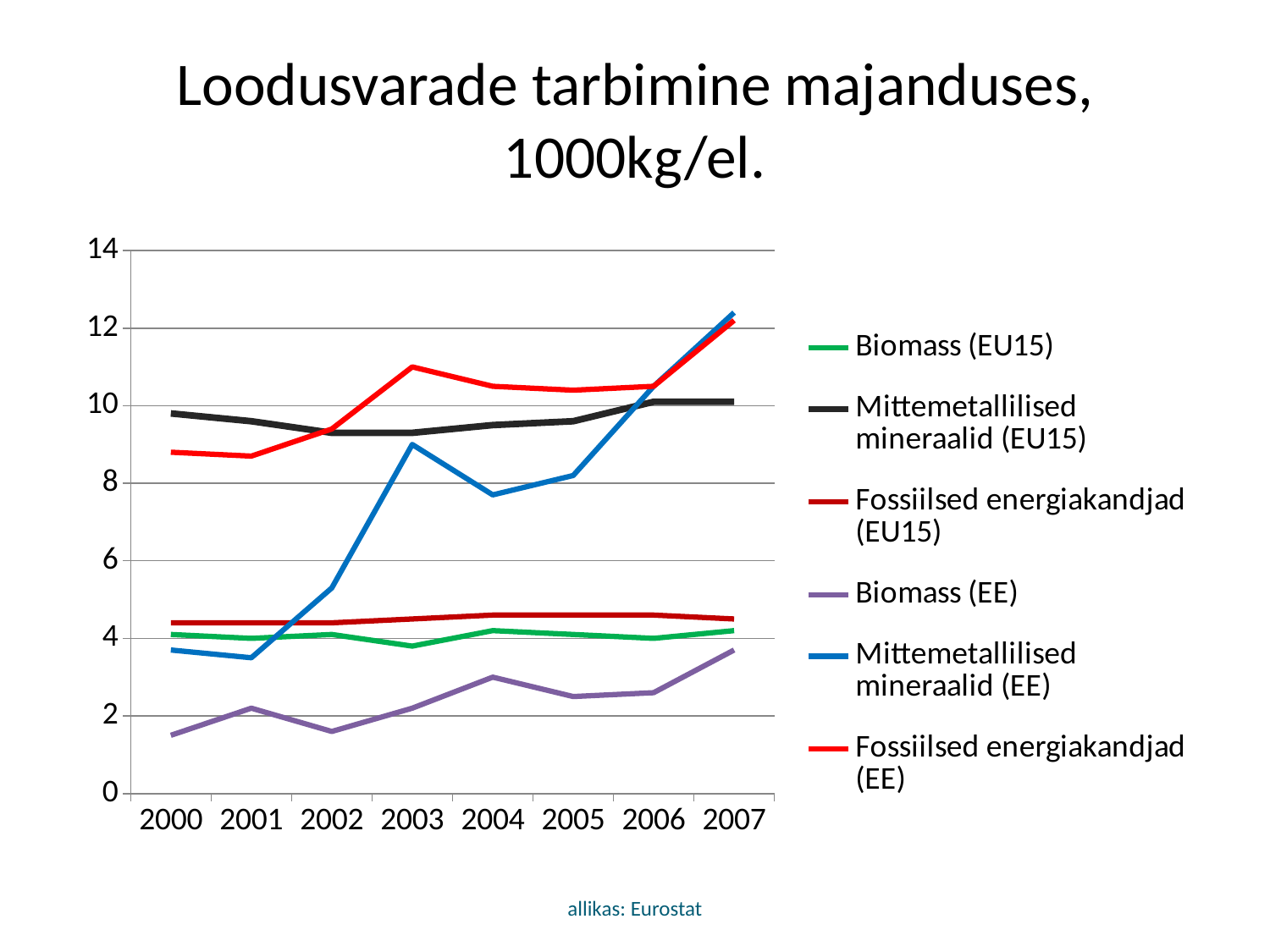
How many years are shown on the x axis? 8 Is the value for Biomass (EU15) in 2004 greater or less than 6? less In 2000, which is higher: Mittemetallilised mineraalid (EU15) or Fossiilsed energiakandjad (EE)? Mittemetallilised mineraalid (EU15) Is the value for Fossiilsed energiakandjad (EE) in 2003 greater or less than 10? greater How many series does the legend list? 6 Is the value for Biomass (EE) in 2000 greater or less than 2? less In 2007, which is higher: Mittemetallilised mineraalid (EE) or Mittemetallilised mineraalid (EU15)? Mittemetallilised mineraalid (EE) Does the value for Mittemetallilised mineraalid (EE) rise or fall from 2001 to 2003? rise Which series has the lowest value in 2000? Biomass (EE) What is the title of the chart? Loodusvarade tarbimine majanduses, 1000kg/el. What kind of chart is shown on the slide? line chart